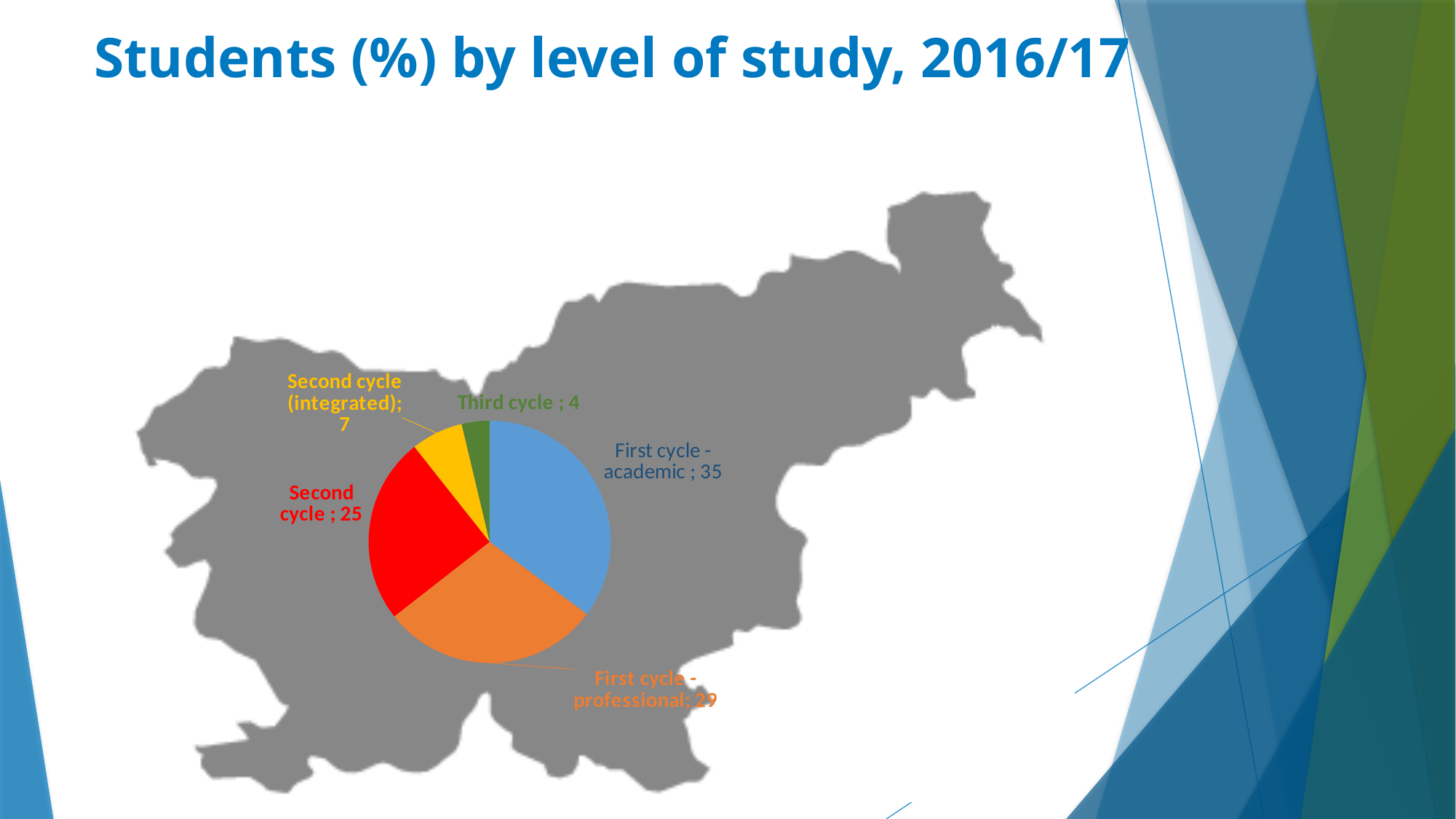
How many slices does the pie chart have? 5 Which level of study has the smallest slice of the pie? Third cycle What type of chart is shown on the slide? Pie chart Which is larger, the value for First cycle - professional or the value for Second cycle? First cycle - professional Which level of study has the largest slice of the pie? First cycle - academic What is the value for First cycle - professional? 29 What is the value for Second cycle (integrated)? 7 What is the difference between the values for First cycle - academic and Second cycle? 10 What is the title of the slide? Students (%) by level of study, 2016/17 What is the value for Second cycle? 25 What is the value for Third cycle? 4 What is the value for First cycle - academic? 35